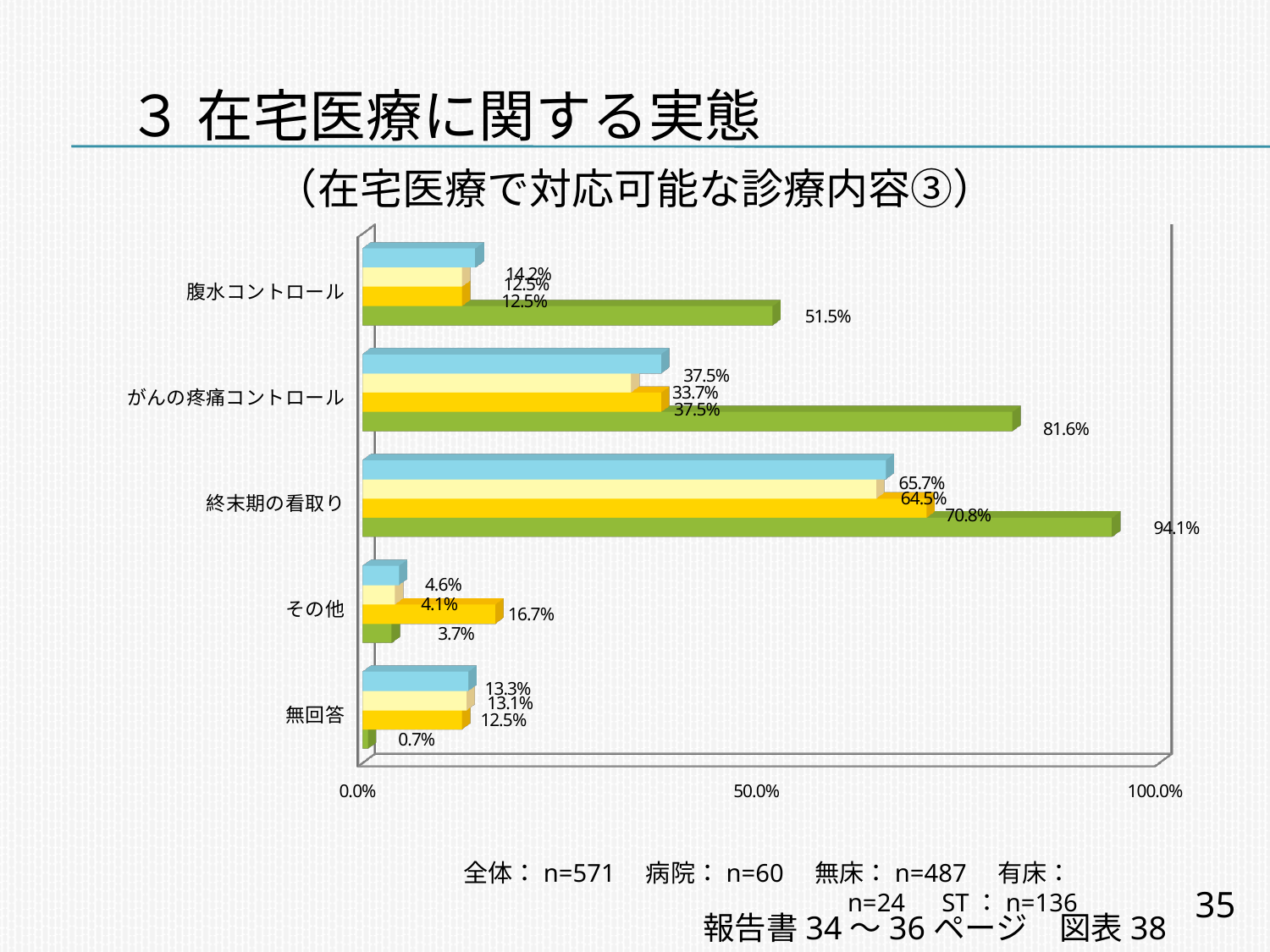
What kind of chart is shown on the slide? bar chart What is the value of the green bar for 腹水コントロール? 51.5% What is the value of the green bar for 無回答? 0.7% Which is larger for 終末期の看取り: the green bar or the blue (top) bar? the green bar What is the value of the green bar for 終末期の看取り? 94.1% Is the green bar for 腹水コントロール greater or less than 50.0%? greater What is the value of the green bar for がんの疼痛コントロール? 81.6% What is the difference between the green bar values for 終末期の看取り and がんの疼痛コントロール? 12.5% How many categories are shown on the vertical axis of the chart? 5 What is the value of the yellow (third) bar for その他? 16.7% Which category has the highest value for the green bar? 終末期の看取り Which category has the lowest value for the green bar? 無回答